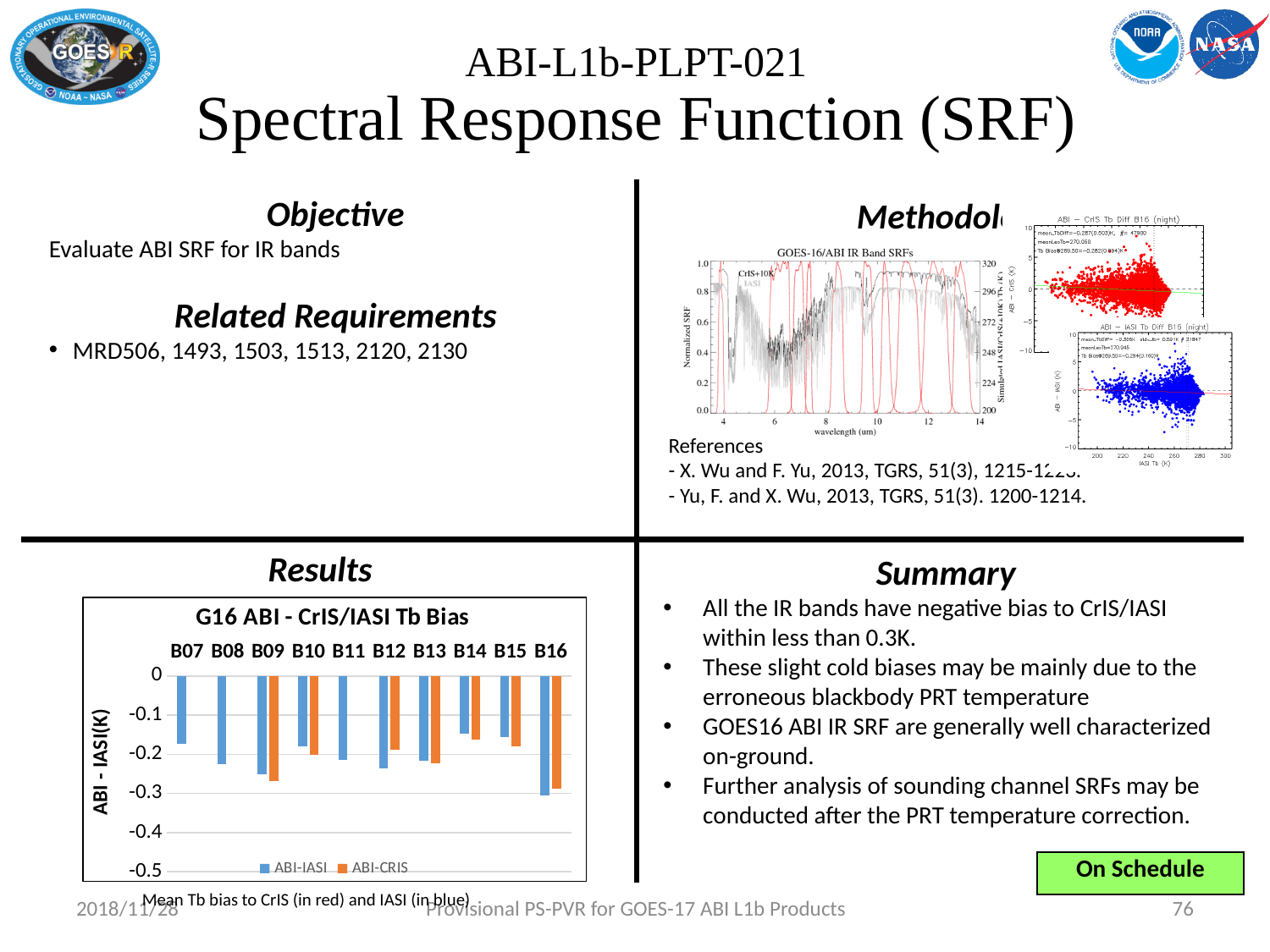
In the 'G16 ABI - CrIS/IASI Tb Bias' chart, which colour represents the ABI-CRIS series? orange In the 'G16 ABI - CrIS/IASI Tb Bias' chart, is the ABI-CRIS value for B16 greater or less than -0.2? less In the 'G16 ABI - CrIS/IASI Tb Bias' chart, is the ABI-IASI value for B14 greater or less than -0.2? greater How many bands (categories) are shown on the x axis of the 'G16 ABI - CrIS/IASI Tb Bias' chart? 10 How many series does the legend of the 'G16 ABI - CrIS/IASI Tb Bias' chart list? 2 In the 'G16 ABI - CrIS/IASI Tb Bias' chart, which band has the lowest (most negative) ABI-IASI value? B16 In the 'G16 ABI - CrIS/IASI Tb Bias' chart, which has the larger (less negative) ABI-IASI value, B14 or B16? B14 In the 'G16 ABI - CrIS/IASI Tb Bias' chart, is the ABI-CRIS value for B09 greater or less than -0.2? less What is the y-axis label of the 'G16 ABI - CrIS/IASI Tb Bias' chart? ABI - IASI(K) What kind of chart is the 'G16 ABI - CrIS/IASI Tb Bias' chart? bar chart